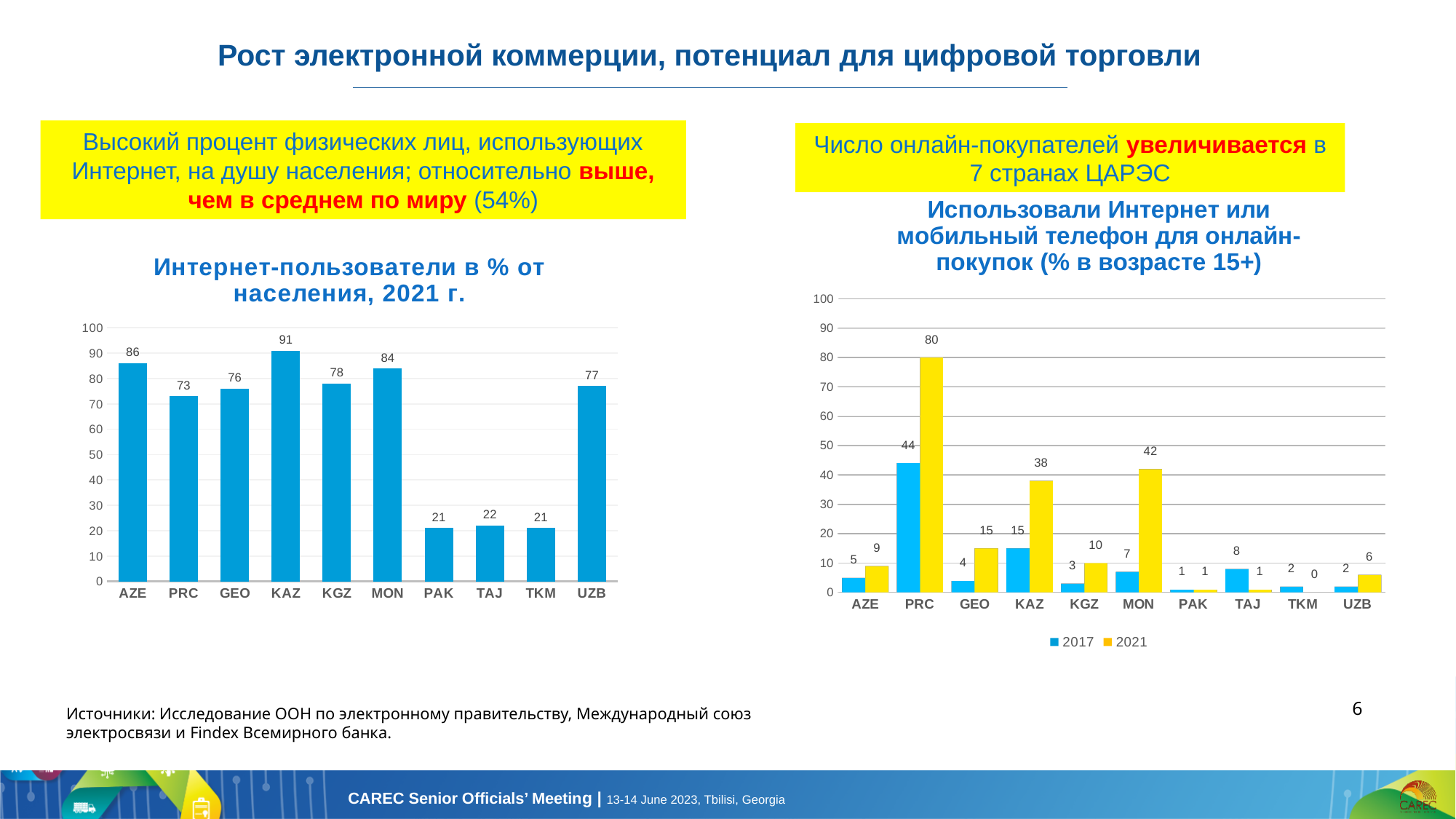
In the right chart (Использовали Интернет или мобильный телефон для онлайн-покупок), which is larger for MON: the 2017 value or the 2021 value? 2021 In the right chart (Использовали Интернет или мобильный телефон для онлайн-покупок), how many series does the legend list? 2 In the left chart (Интернет-пользователи в % от населения, 2021 г.), which country has the lowest value? PAK and TKM (both 21) In the right chart (Использовали Интернет или мобильный телефон для онлайн-покупок), what is the 2017 value for KAZ? 15 In the left chart (Интернет-пользователи в % от населения, 2021 г.), how many countries are shown? 10 In the left chart (Интернет-пользователи в % от населения, 2021 г.), what is the difference between AZE and PRC? 13 In the left chart (Интернет-пользователи в % от населения, 2021 г.), what is the value for KAZ? 91 In the right chart (Использовали Интернет или мобильный телефон для онлайн-покупок), what is the difference between the 2021 and 2017 values for GEO? 11 What type of chart is the left chart (Интернет-пользователи в % от населения, 2021 г.)? Bar chart In the right chart (Использовали Интернет или мобильный телефон для онлайн-покупок), what is the 2021 value for PRC? 80 In the right chart (Использовали Интернет или мобильный телефон для онлайн-покупок), which colour represents the 2021 series? Yellow In the left chart (Интернет-пользователи в % от населения, 2021 г.), which country has the highest value? KAZ